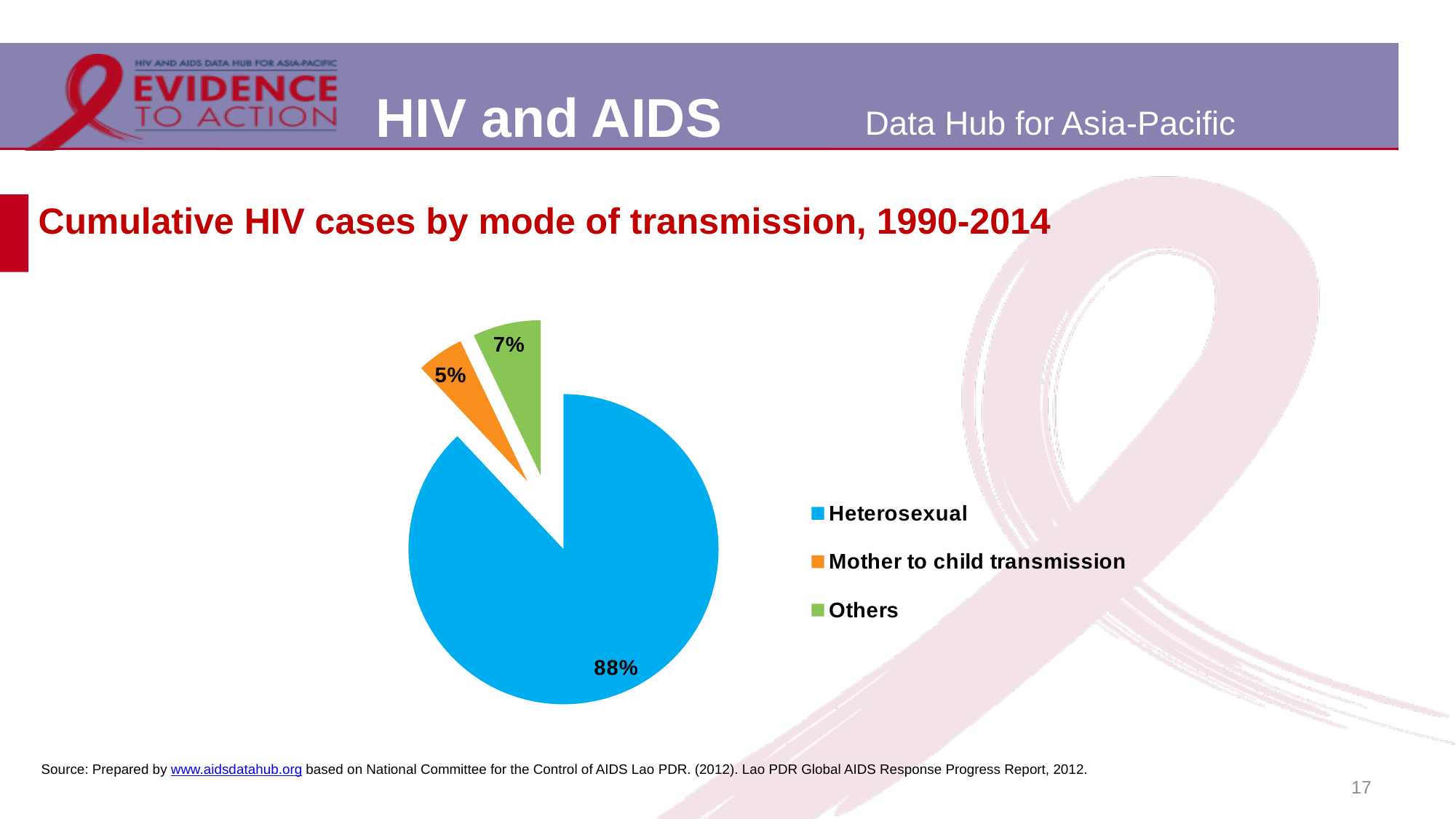
What is the difference in percentage points between the Others share and the Mother to child transmission share? 2 Which mode of transmission accounts for the largest share of cumulative HIV cases? Heterosexual Which is larger, the share for Others or the share for Mother to child transmission? Others What share of cumulative HIV cases is attributed to Heterosexual transmission? 88% What is the difference in percentage points between the Heterosexual share and the Others share? 81 Which mode of transmission accounts for the smallest share of cumulative HIV cases? Mother to child transmission How many slices does the pie chart have? 3 What is the title of the chart? Cumulative HIV cases by mode of transmission, 1990-2014 What colour is the slice for Mother to child transmission? orange What share of cumulative HIV cases is attributed to Others? 7% What share of cumulative HIV cases is attributed to Mother to child transmission? 5% What kind of chart is shown on the slide? pie chart